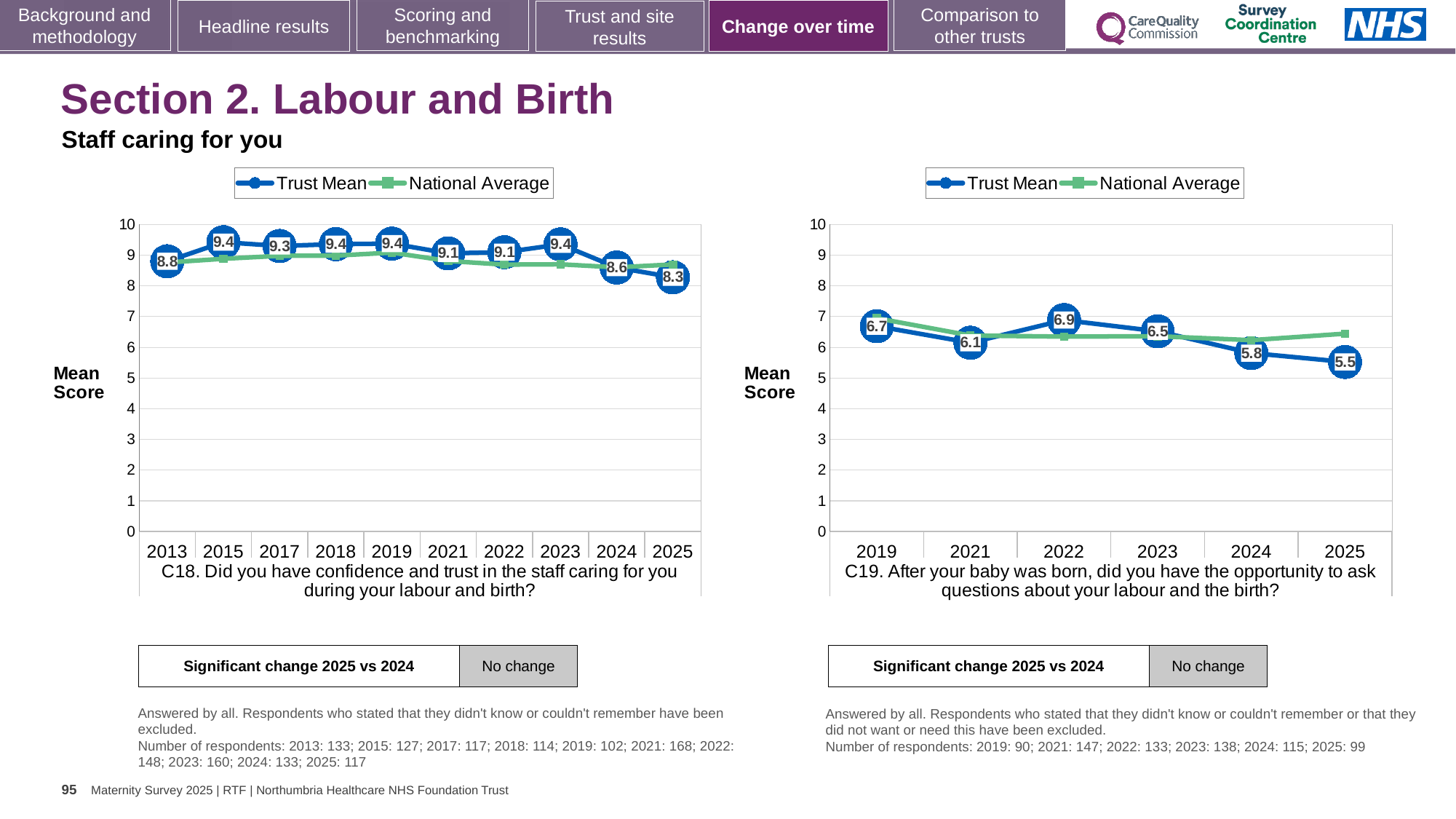
In the C18 chart on the left, what is the Trust Mean score for 2013? 8.8 In the C18 chart on the left, what is the Trust Mean score for 2025? 8.3 In the C19 chart on the right, is the National Average value for 2025 greater or less than 6? greater What kind of chart is the C19 chart on the right? Line chart In the C19 chart on the right, which year has the highest Trust Mean score? 2022 How many years are plotted on the x axis of the C18 chart on the left? 10 How many series does the legend of the C19 chart on the right list? 2 In the C18 chart on the left, which year has the lowest Trust Mean score? 2025 In the C18 chart on the left, is the Trust Mean score higher in 2023 or in 2024? 2023 In the C19 chart on the right, what is the Trust Mean score for 2022? 6.9 In the C19 chart on the right, what is the difference between the Trust Mean scores for 2019 and 2025? 1.2 In the C19 chart on the right, which year has the lowest Trust Mean score? 2025